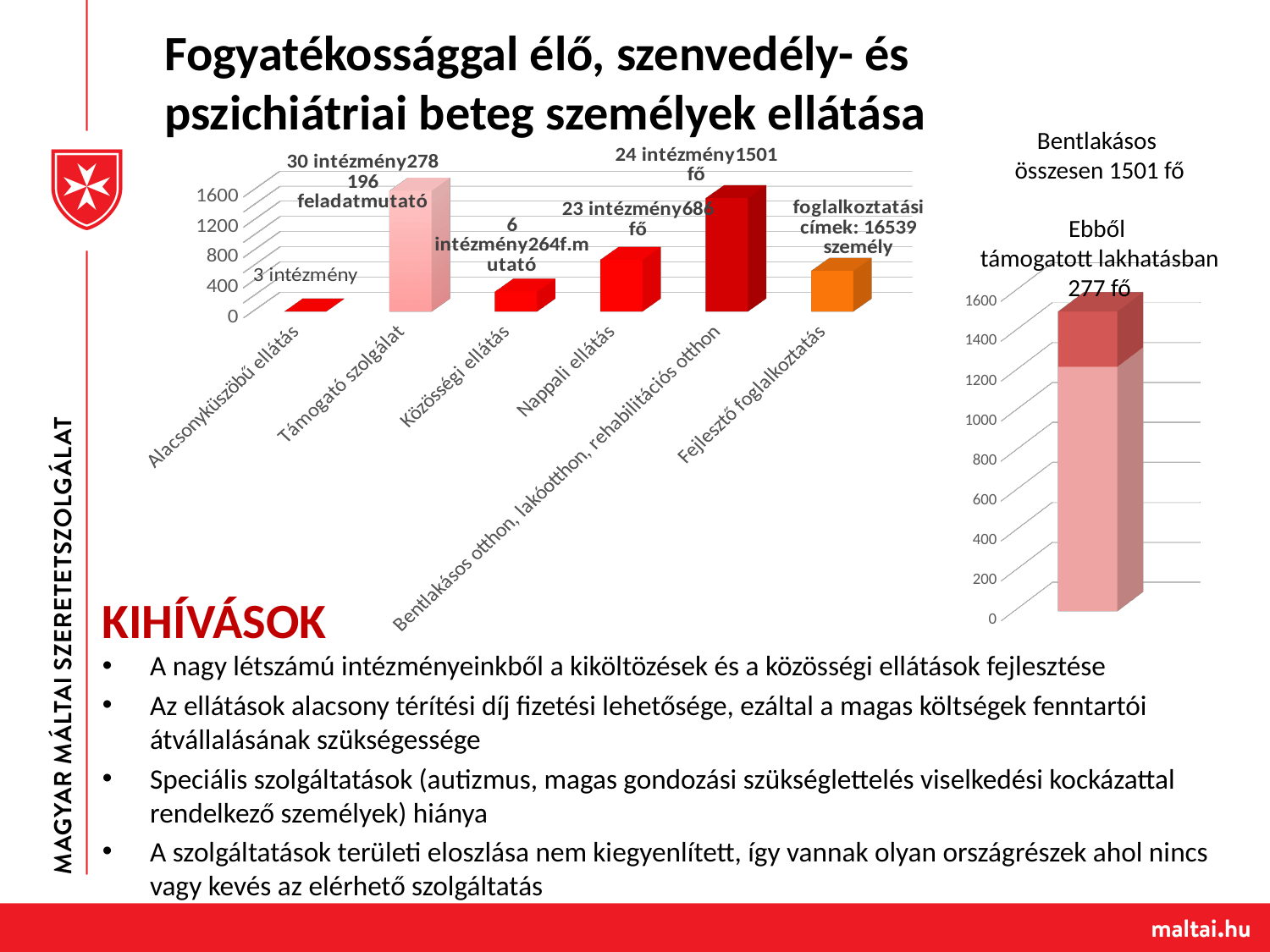
On the left chart, how many categories are shown on the x axis? 6 On the left chart, is the value for Nappali ellátás greater or less than 400? greater On the right chart, how many fő are in Bentlakásos összesen? 1501 fő On the left chart, is the value for Fejlesztő foglalkoztatás greater or less than 800? less On the left chart, how many intézmény are labelled for Támogató szolgálat? 30 intézmény On the left chart, how many fő are labelled for Nappali ellátás? 686 fő On the left chart, which is larger: the value for Nappali ellátás or for Bentlakásos otthon, lakóotthon, rehabilitációs otthon? Bentlakásos otthon, lakóotthon, rehabilitációs otthon On the left chart, how many fő are labelled for Bentlakásos otthon, lakóotthon, rehabilitációs otthon? 1501 fő On the left chart, which category has the lowest bar? Alacsonyküszöbű ellátás On the left chart, what kind of chart is shown? bar chart On the left chart, how many intézmény are labelled for Alacsonyküszöbű ellátás? 3 intézmény On the right chart, how many fő are in támogatott lakhatás? 277 fő